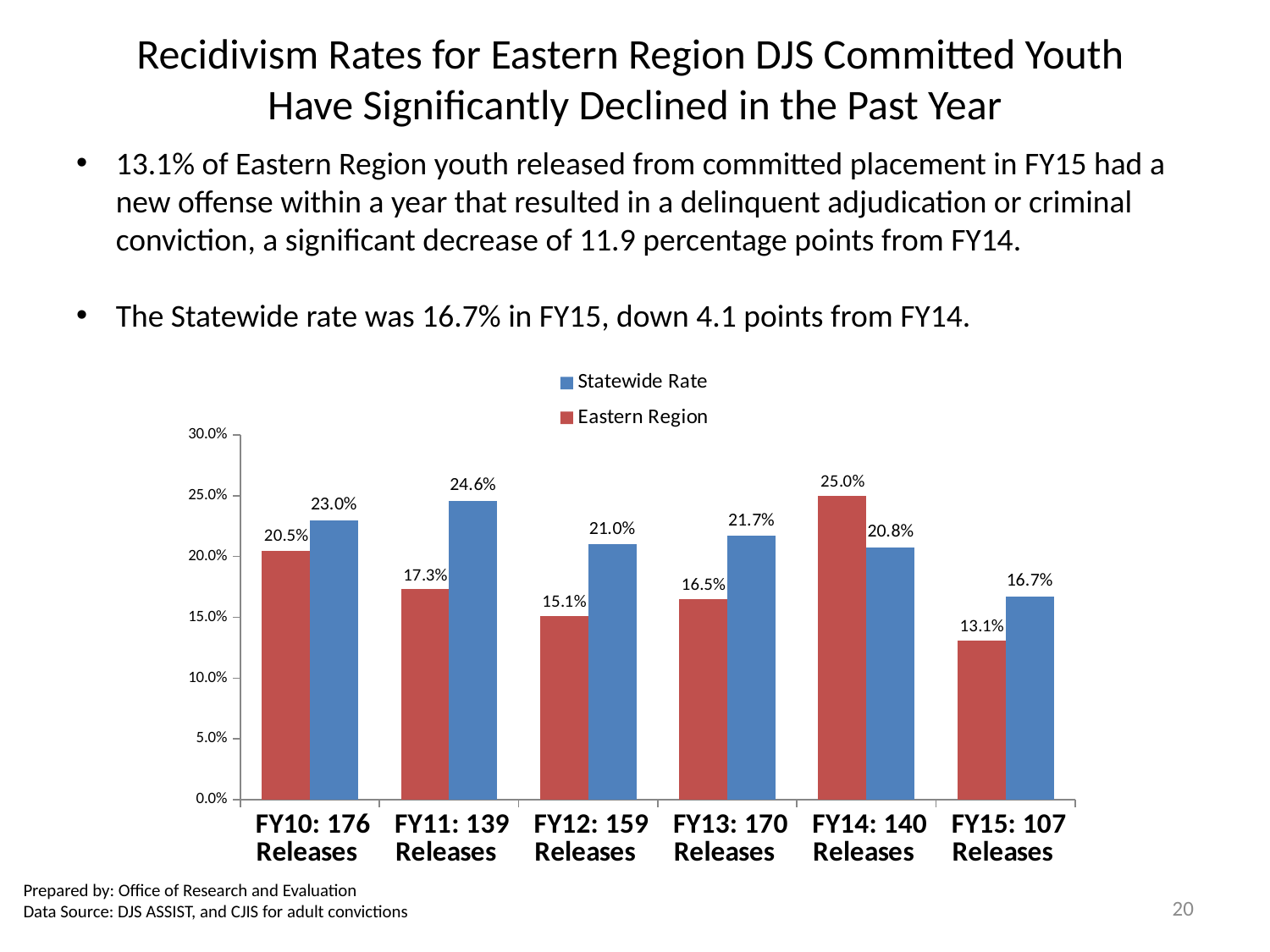
Which colour represents the Statewide Rate in the chart? Blue What is the Eastern Region rate for FY14: 140 Releases? 25.0% Is the Statewide Rate for FY13: 170 Releases greater or less than 20.0%? greater What is the difference between the Eastern Region rate in FY14: 140 Releases and FY15: 107 Releases? 11.9 percentage points What kind of chart is shown on the slide? Bar chart Which is larger for FY14: 140 Releases, the Eastern Region rate or the Statewide Rate? Eastern Region What is the Statewide Rate for FY11: 139 Releases? 24.6% How many series does the legend list? 2 What is the Eastern Region recidivism rate for FY15: 107 Releases? 13.1% How many fiscal year categories are shown on the x axis? 6 Which fiscal year category has the lowest Statewide Rate? FY15: 107 Releases Which fiscal year category has the highest Eastern Region rate? FY14: 140 Releases